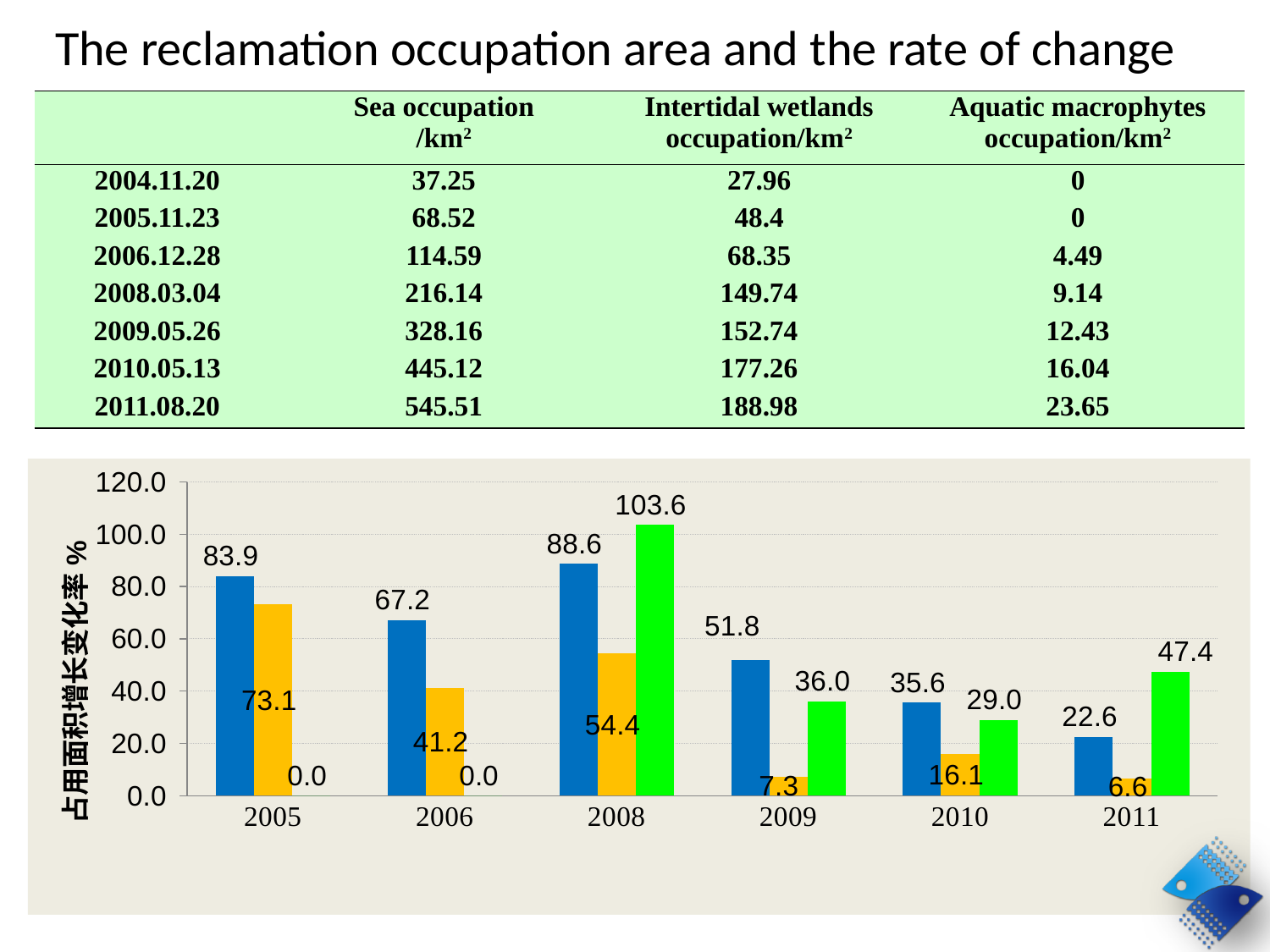
Which year has the lowest yellow bar? 2011 What is the difference between the blue bar values for 2005 and 2011? 61.3 What is the value of the yellow bar for 2010? 16.1 Which is larger for 2009, the blue bar or the green bar? the blue bar Is the value of the green bar for 2011 greater or less than 40.0? greater How many year categories are shown on the x axis of the chart? 6 Which year has the highest blue bar? 2008 Do the blue bar values rise or fall from 2008 to 2011? fall What is the value of the blue bar for 2005? 83.9 What is the label on the vertical axis of the chart? 占用面积增长变化率 % What type of chart is shown on the slide? bar chart What is the value of the green bar for 2008? 103.6